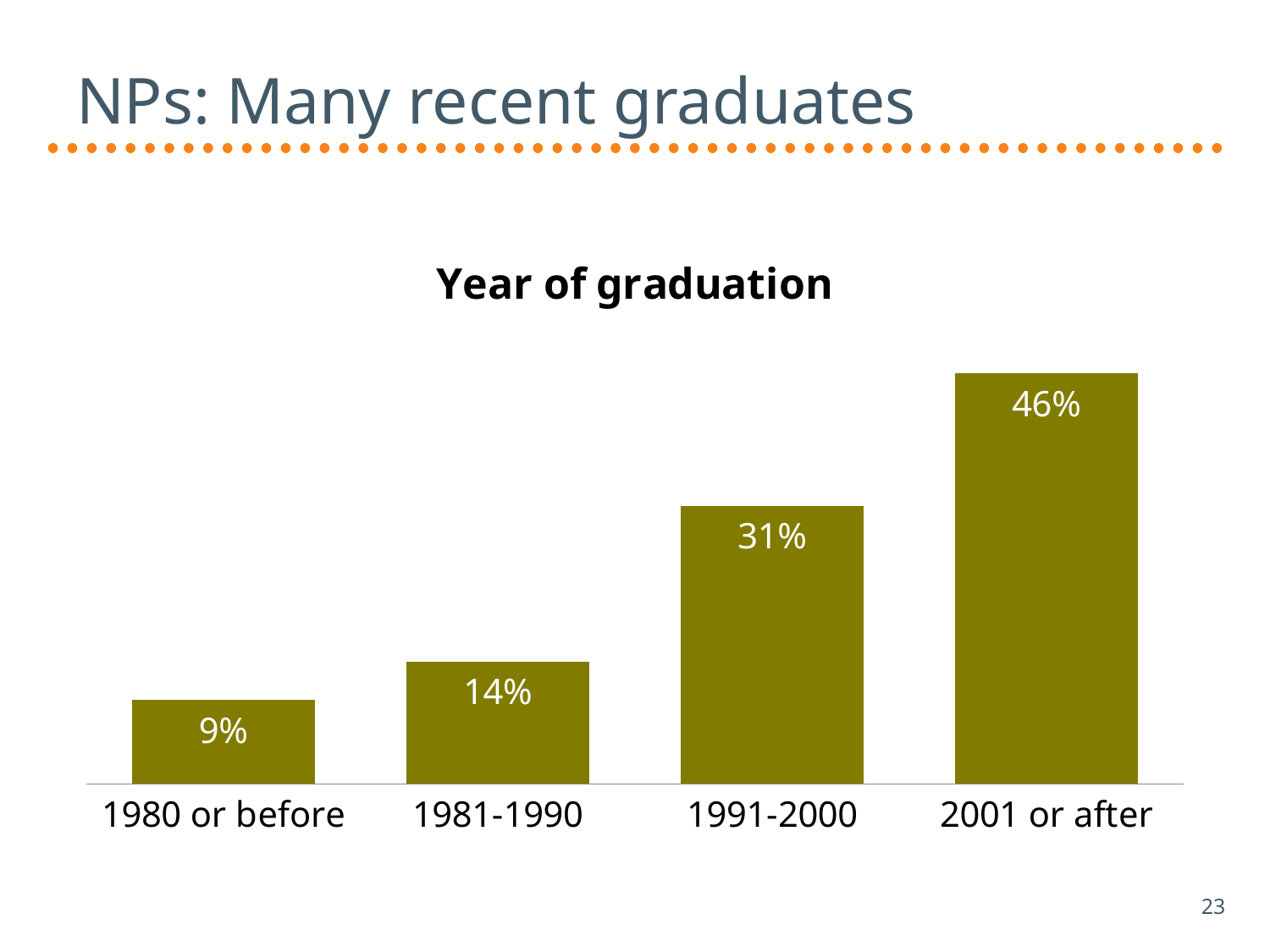
What is the value shown for the 1981-1990 category? 14% Which year-of-graduation category has the highest value? 2001 or after What kind of chart is shown on the slide? Bar chart What is the title of the chart? Year of graduation What percentage is shown for 1991-2000? 31% What is the difference between the values for 1981-1990 and 1980 or before? 5% What is the difference between the values for 2001 or after and 1991-2000? 15% Do the values rise or fall moving from left to right along the x axis? Rise What percentage of NPs graduated in 2001 or after? 46% Which year-of-graduation category has the lowest value? 1980 or before How many year-of-graduation categories are shown in the chart? 4 Which is larger, the value for 1991-2000 or the value for 1981-1990? 1991-2000